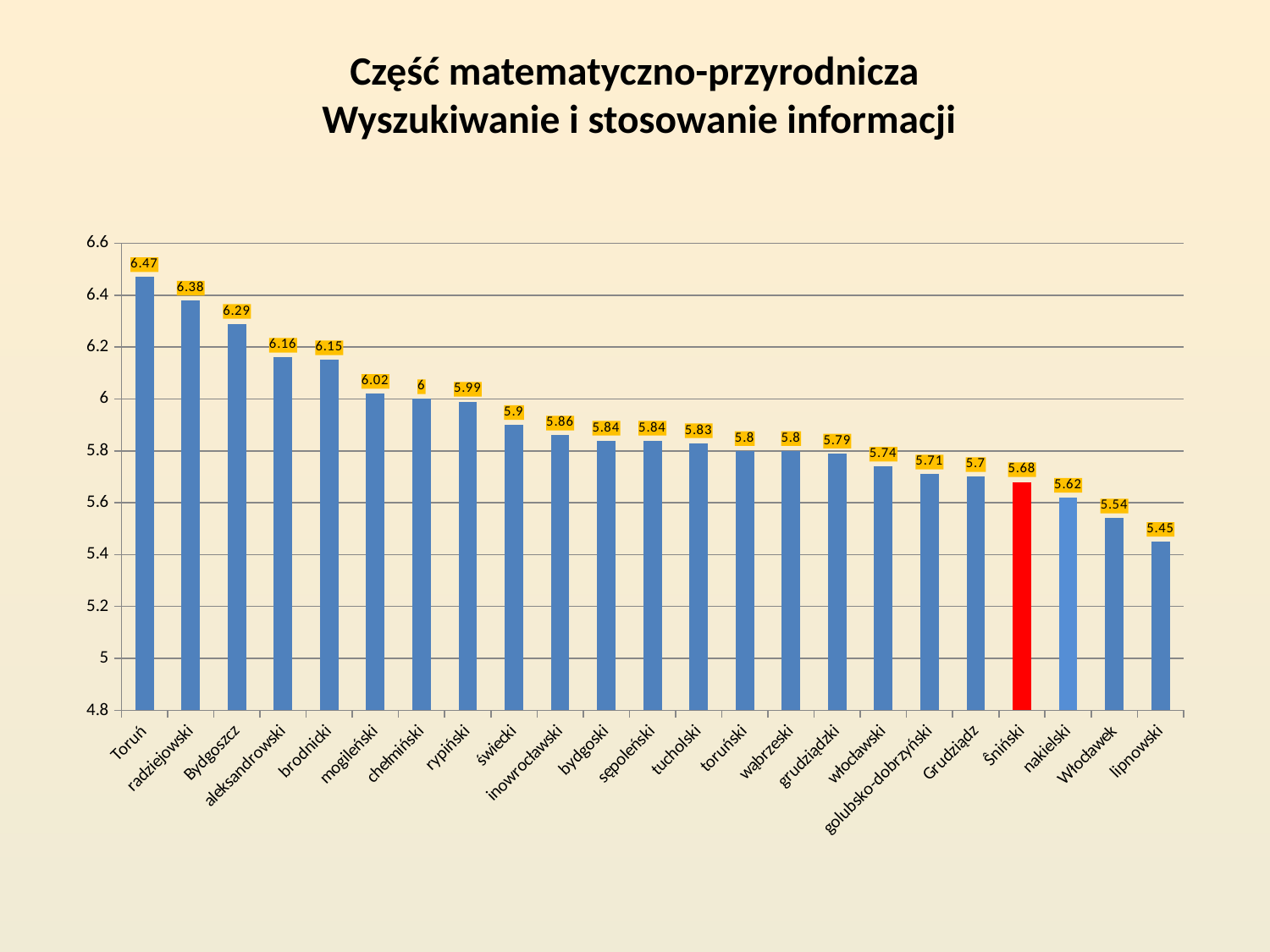
Which category has the highest value? Toruń What is the difference between the values for Bydgoszcz and Grudziądz? 0.59 Do the values rise or fall from left to right along the x axis? fall Which category has the lowest value? lipnowski How many categories are shown on the x axis? 23 What is the difference between the values for Toruń and lipnowski? 1.02 Which is larger, the value for radziejowski or the value for aleksandrowski? radziejowski What is the value for mogileński? 6.02 What kind of chart is shown on the slide? bar chart What is the value for Włocławek? 5.54 What is the value for the red bar (żniński)? 5.68 What is the value for Toruń? 6.47